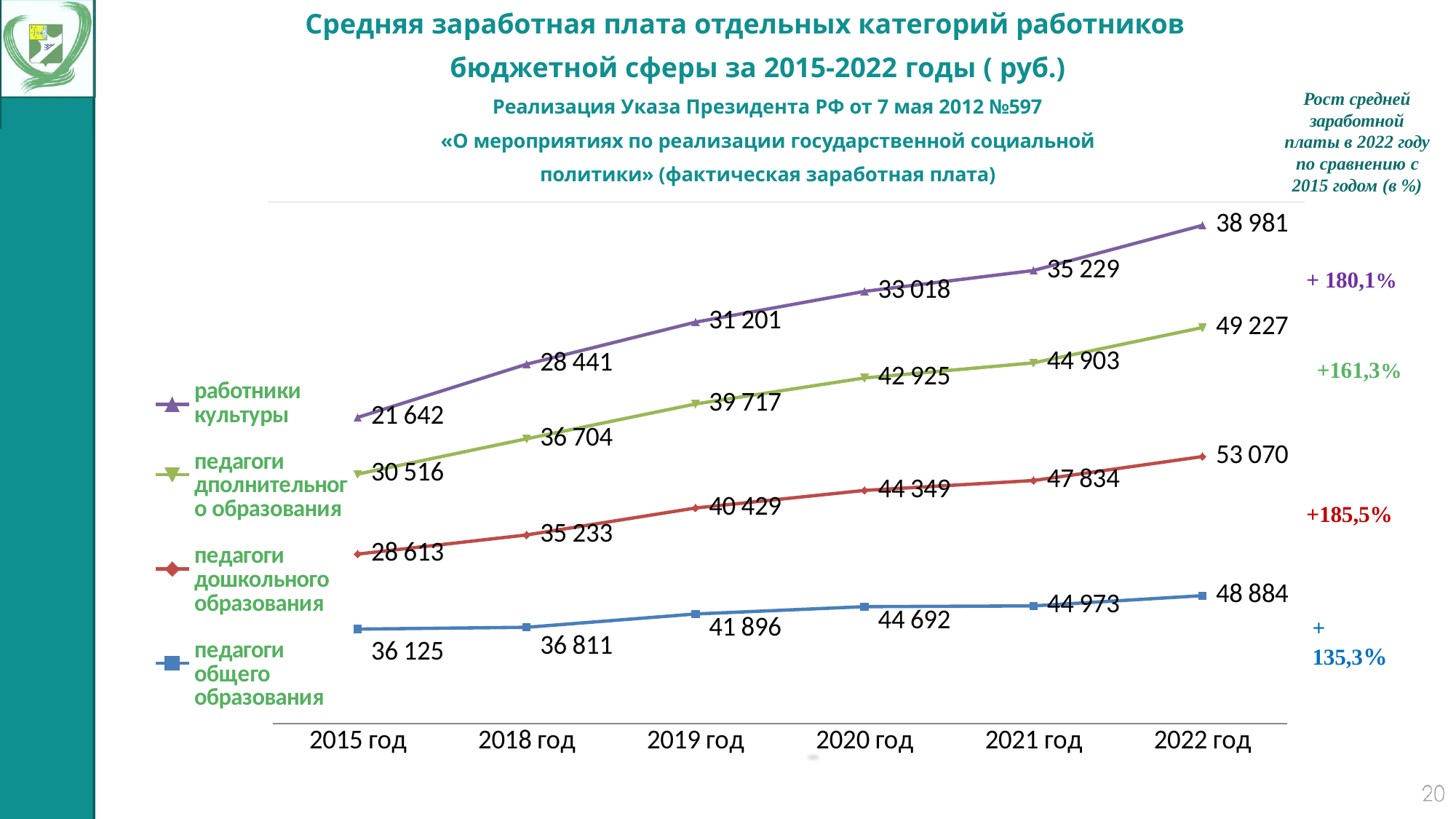
What is the value for работники культуры in 2022 год? 38 981 How many years are shown on the x axis? 6 Do the values for педагоги дошкольного образования rise or fall from 2015 год to 2022 год? rise In which year is the value for работники культуры lowest? 2015 год What is the value for педагоги дополнительного образования in 2020 год? 42 925 What is the difference between the 2022 год and 2015 год values for педагоги общего образования? 12 759 What kind of chart is shown on the slide? line chart Which series has the highest value in 2022 год? педагоги дошкольного образования What is the value for педагоги общего образования in 2019 год? 41 896 Which is larger in 2018 год: the value for педагоги дополнительного образования or педагоги дошкольного образования? педагоги дополнительного образования How many series does the legend list? 4 What is the value for педагоги дошкольного образования in 2015 год? 28 613